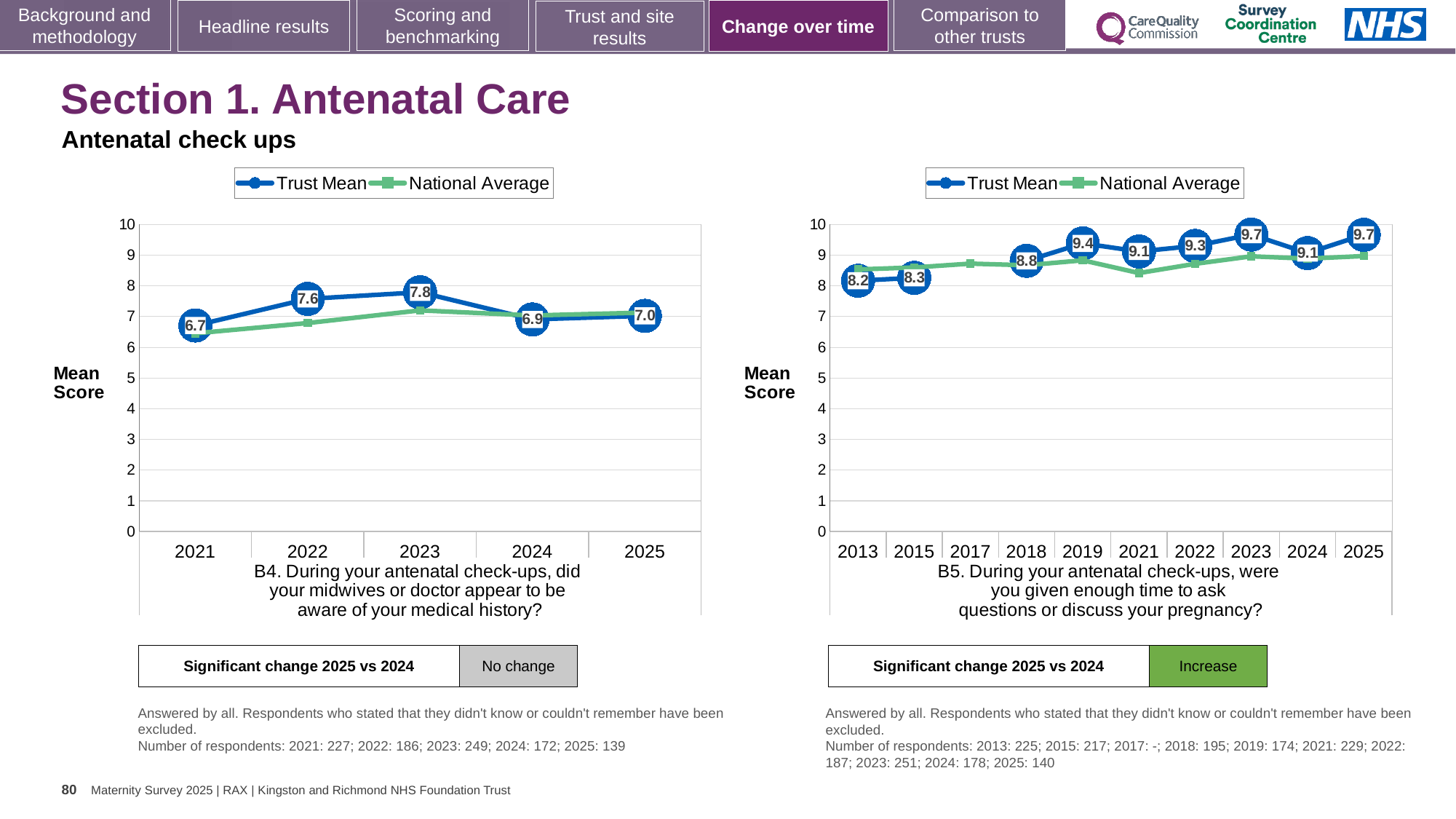
In the B5 chart (right), is the National Average value for 2013 greater or less than 8? greater How many series does the legend of the B5 chart (right) list? 2 In the B5 chart (right), which year has the lowest Trust Mean score? 2013 In the B4 chart (left), how many years are shown on the x axis? 5 In the B5 chart (right), what is the Trust Mean score for 2013? 8.2 In the B4 chart (left), which year has the highest Trust Mean score? 2023 In the B5 chart (right), is the Trust Mean score for 2025 larger than the score for 2024? Yes, 2025 (9.7) is larger than 2024 (9.1) In the B5 chart (right), what is the Trust Mean score for 2019? 9.4 In the B4 chart (left), what is the difference between the Trust Mean scores for 2022 and 2024? 0.7 In the B4 chart (left), what is the Trust Mean score for 2023? 7.8 In the B4 chart (left), what is the Trust Mean score for 2021? 6.7 In the B4 chart (left), which year has the lowest Trust Mean score? 2021